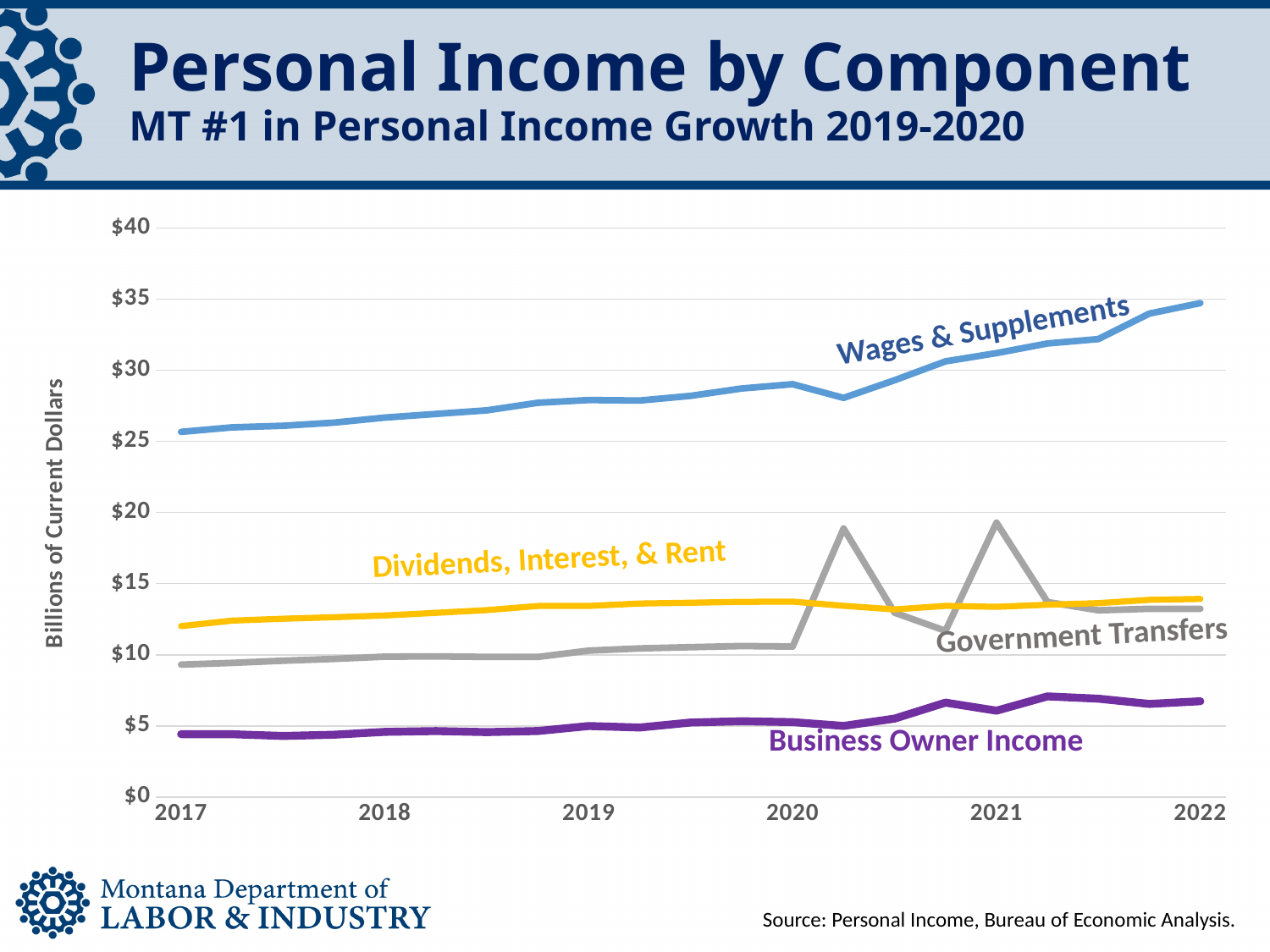
Does the Wages & Supplements line generally rise or fall from 2017 to 2022? rise Is the value for Wages & Supplements in 2022 greater or less than $30? greater Which component has the lowest values throughout the chart? Business Owner Income How many years are labeled on the x axis? 6 In 2019, which is larger: Government Transfers or Business Owner Income? Government Transfers Which component has the highest values throughout the chart? Wages & Supplements What is the label on the vertical axis of the chart? Billions of Current Dollars Is the value for Wages & Supplements in 2017 greater or less than $30? less How many series are plotted on the chart? 4 Is the peak value for Government Transfers in 2021 greater or less than $15? greater What kind of chart is shown on the slide? line chart